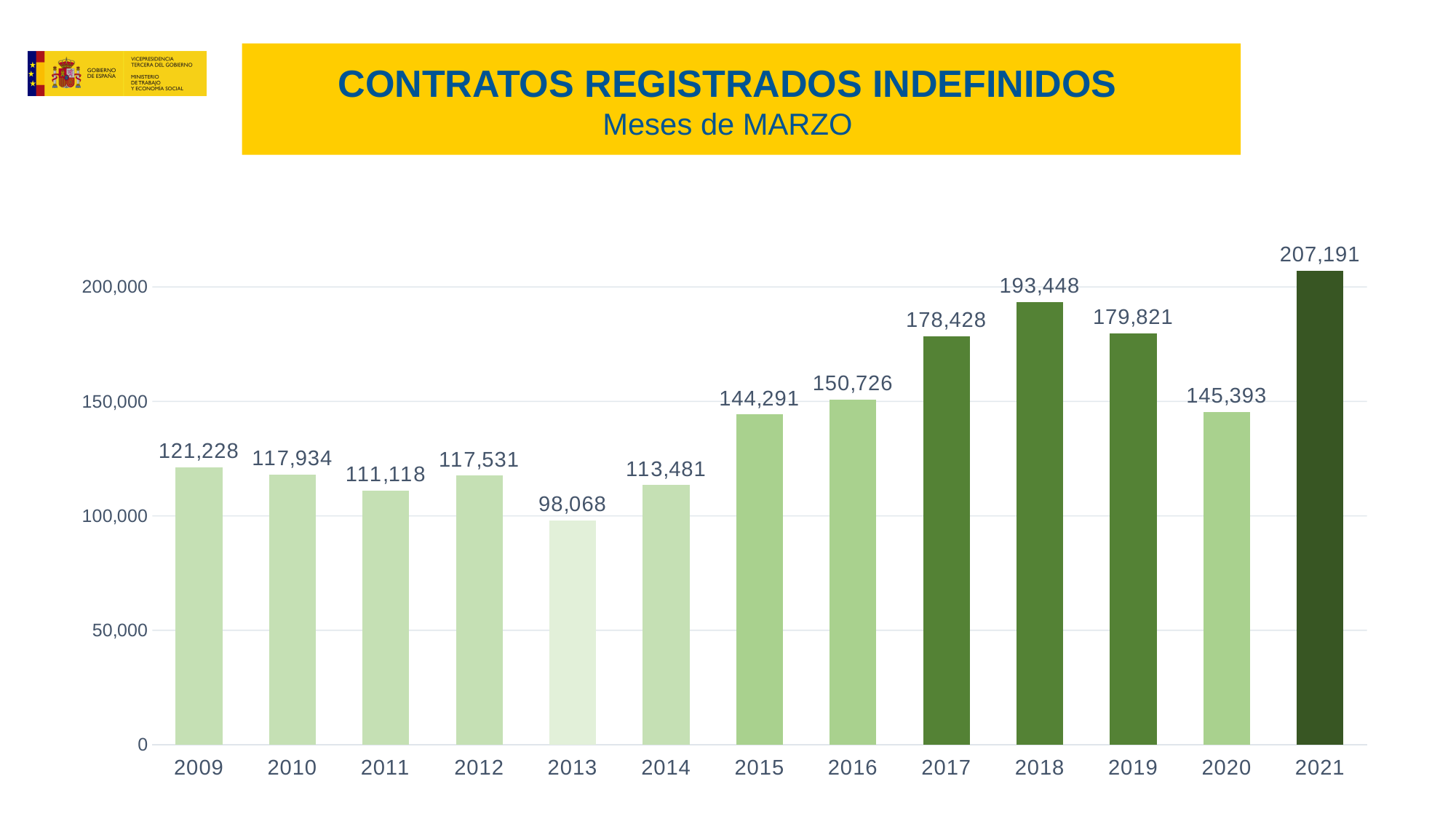
What kind of chart is shown on the slide? bar chart How many years are shown on the x axis? 13 What is the difference between the values for 2018 and 2017? 15,020 Which year has the highest value? 2021 Which year has the lowest value? 2013 Is the value for 2018 greater or less than 200,000? less What is the value for 2021? 207,191 What is the value for 2013? 98,068 What is the title of the chart? CONTRATOS REGISTRADOS INDEFINIDOS Meses de MARZO Which is larger, the value for 2019 or the value for 2020? 2019 What is the value for 2016? 150,726 What is the difference between the values for 2021 and 2020? 61,798